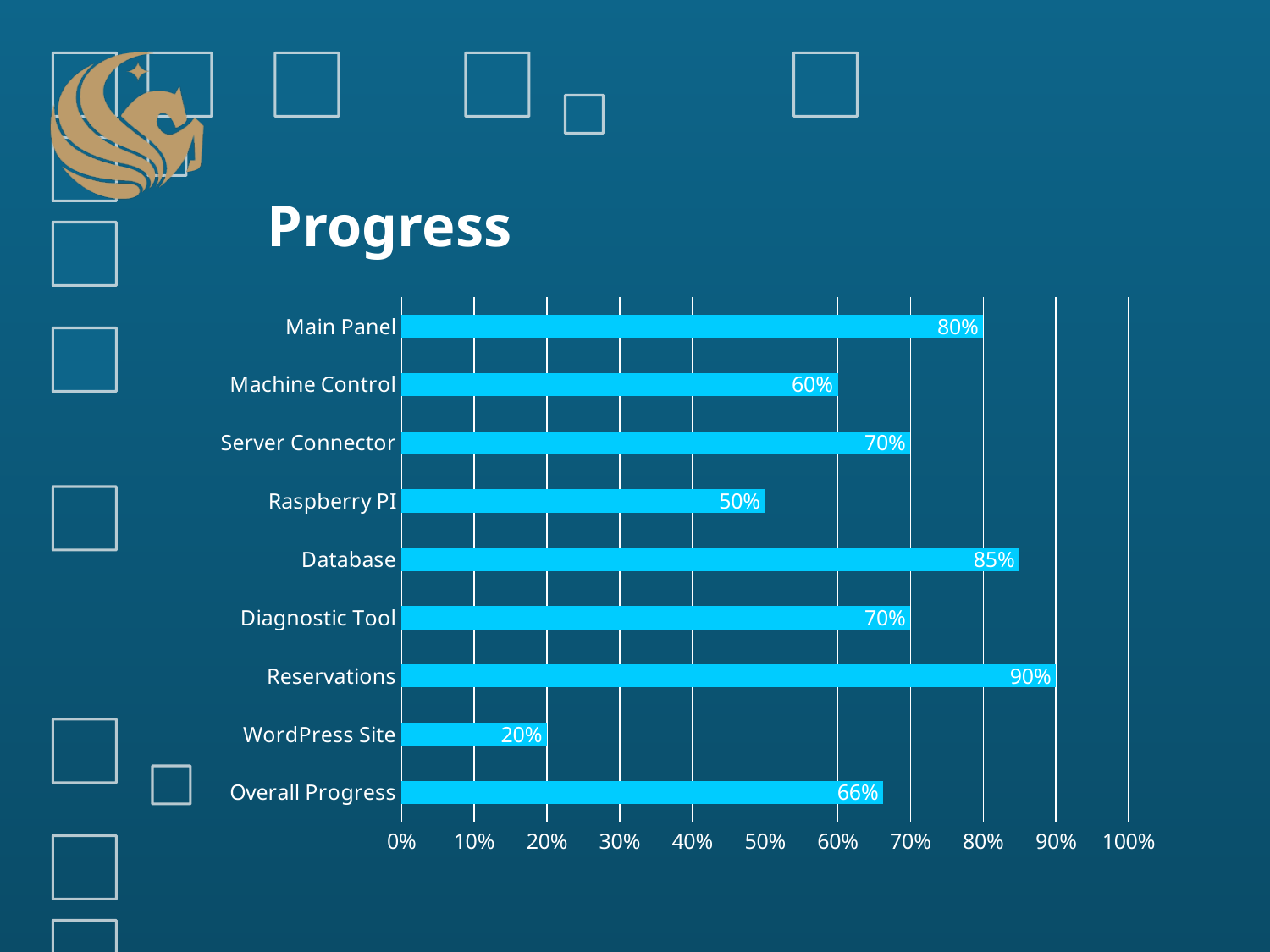
Which category has the lowest value? WordPress Site What is the title of the slide? Progress What is the value for Raspberry PI? 50% What is the value for Overall Progress? 66% What is the value for WordPress Site? 20% What kind of chart is shown on the slide? Bar chart Which is larger, the value for Server Connector or the value for Raspberry PI? Server Connector What is the highest value shown on the x axis? 100% What is the value for Main Panel? 80% What is the difference between the values for Database and Machine Control? 25% How many categories are shown on the chart? 9 Which category has the highest value? Reservations